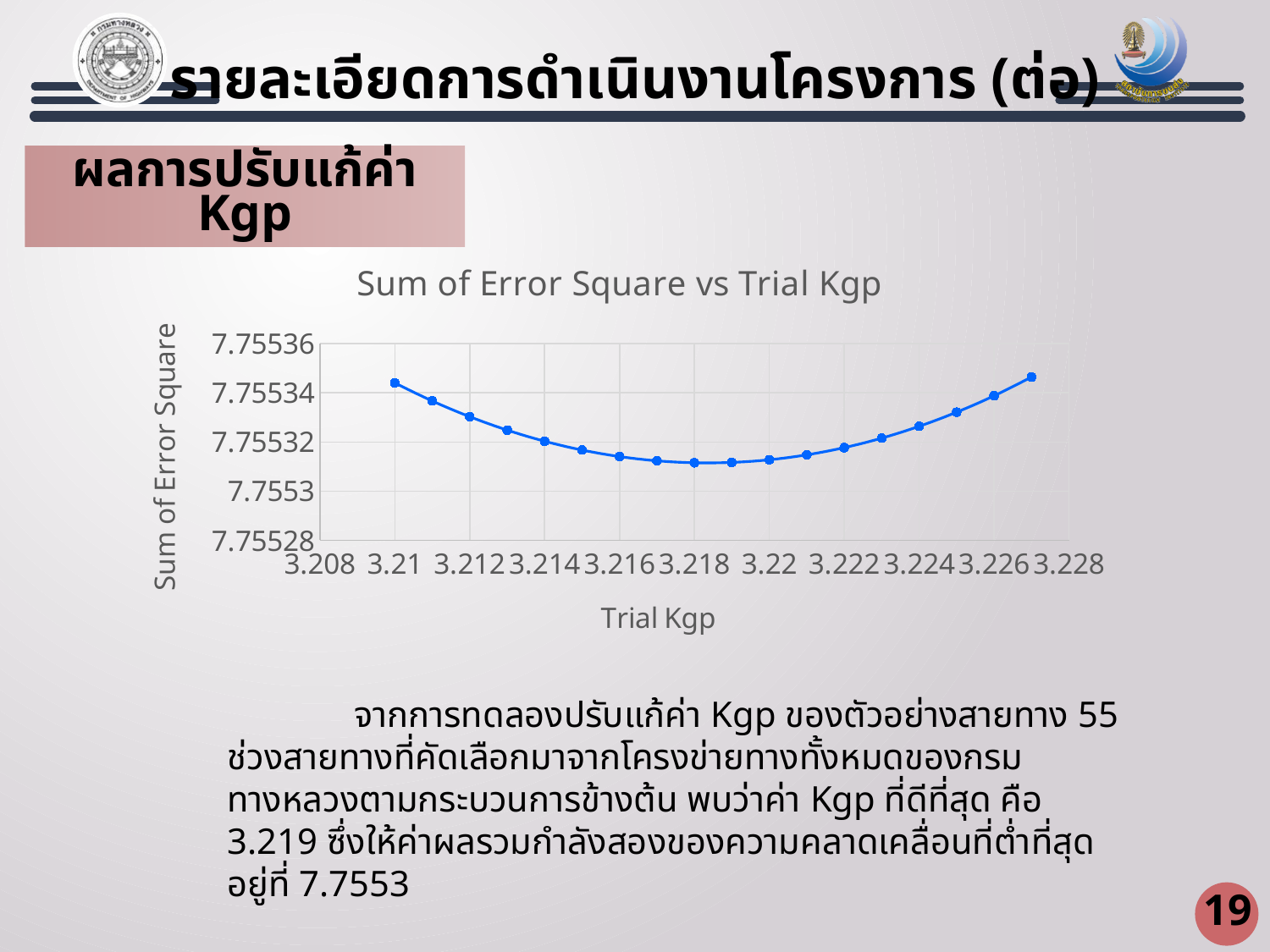
Is the Sum of Error Square at Trial Kgp 3.21 greater or less than 7.75532? greater What type of chart is shown on the slide? Line chart Do the values rise or fall as Trial Kgp increases from 3.21 to 3.218? fall Is the Sum of Error Square at Trial Kgp 3.218 greater or less than 7.75532? less Do the values rise or fall as Trial Kgp increases from 3.219 to 3.227? rise Is the Sum of Error Square at Trial Kgp 3.214 greater or less than 7.7553? greater According to the slide text, which Kgp value gives the lowest Sum of Error Square? 3.219 What is the title of the chart? Sum of Error Square vs Trial Kgp Which has a higher Sum of Error Square: Trial Kgp 3.21 or Trial Kgp 3.218? 3.21 How many data points are plotted on the chart? 18 What is the label of the x axis of the chart? Trial Kgp